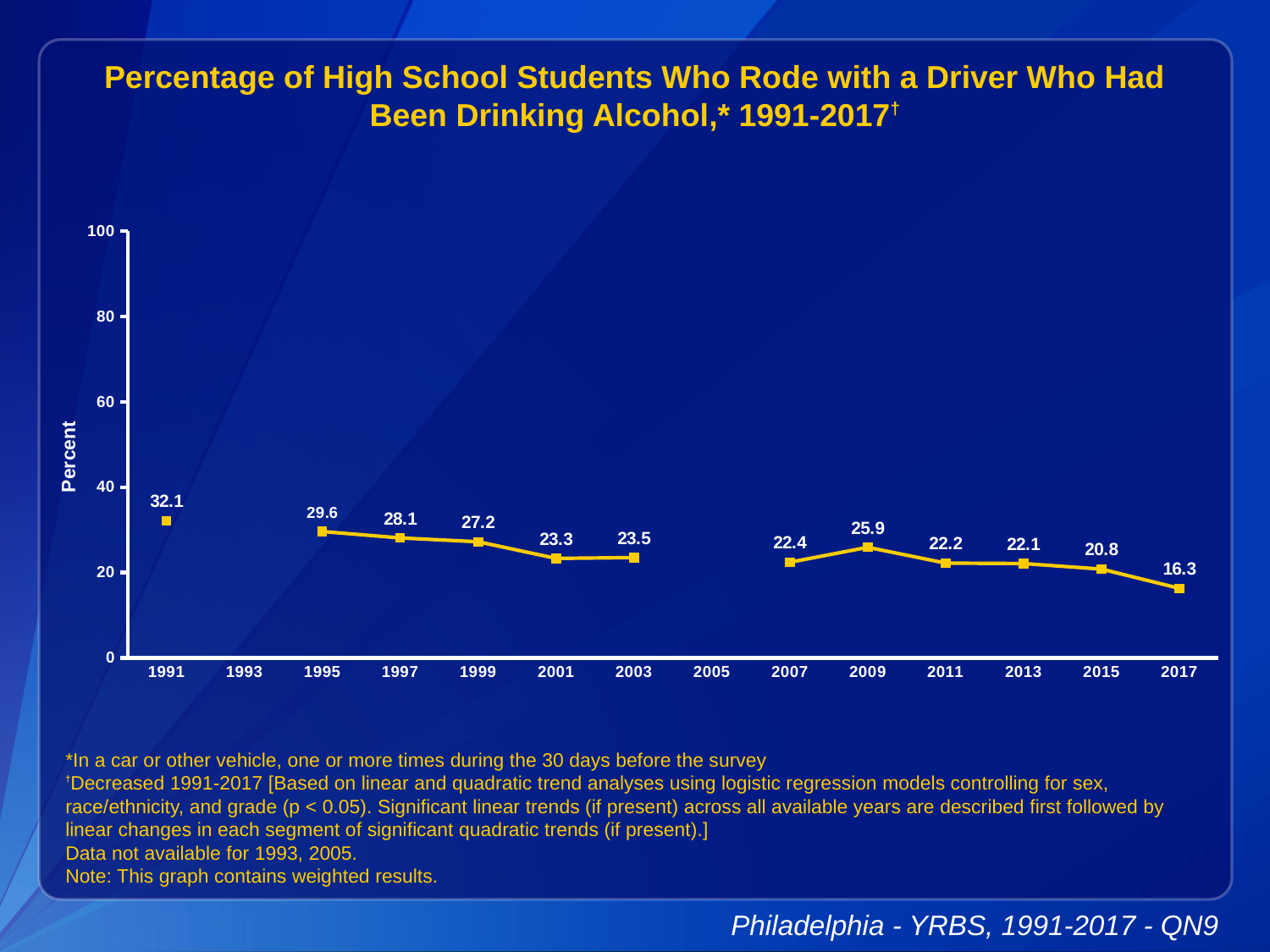
What kind of chart is this? line chart What is the difference between the values for 1991 and 2017? 15.8 Is the value for 1995 greater or less than 20? greater Which year has the highest value? 1991 What is the value for 2009? 25.9 What is the value for 1991? 32.1 Which year has the lowest value? 2017 Which is larger, the value for 2007 or the value for 2009? 2009 What is the label on the y axis? Percent How many data points are plotted on the chart? 12 What is the value for 2017? 16.3 Do the values generally rise or fall from 1991 to 2017? fall